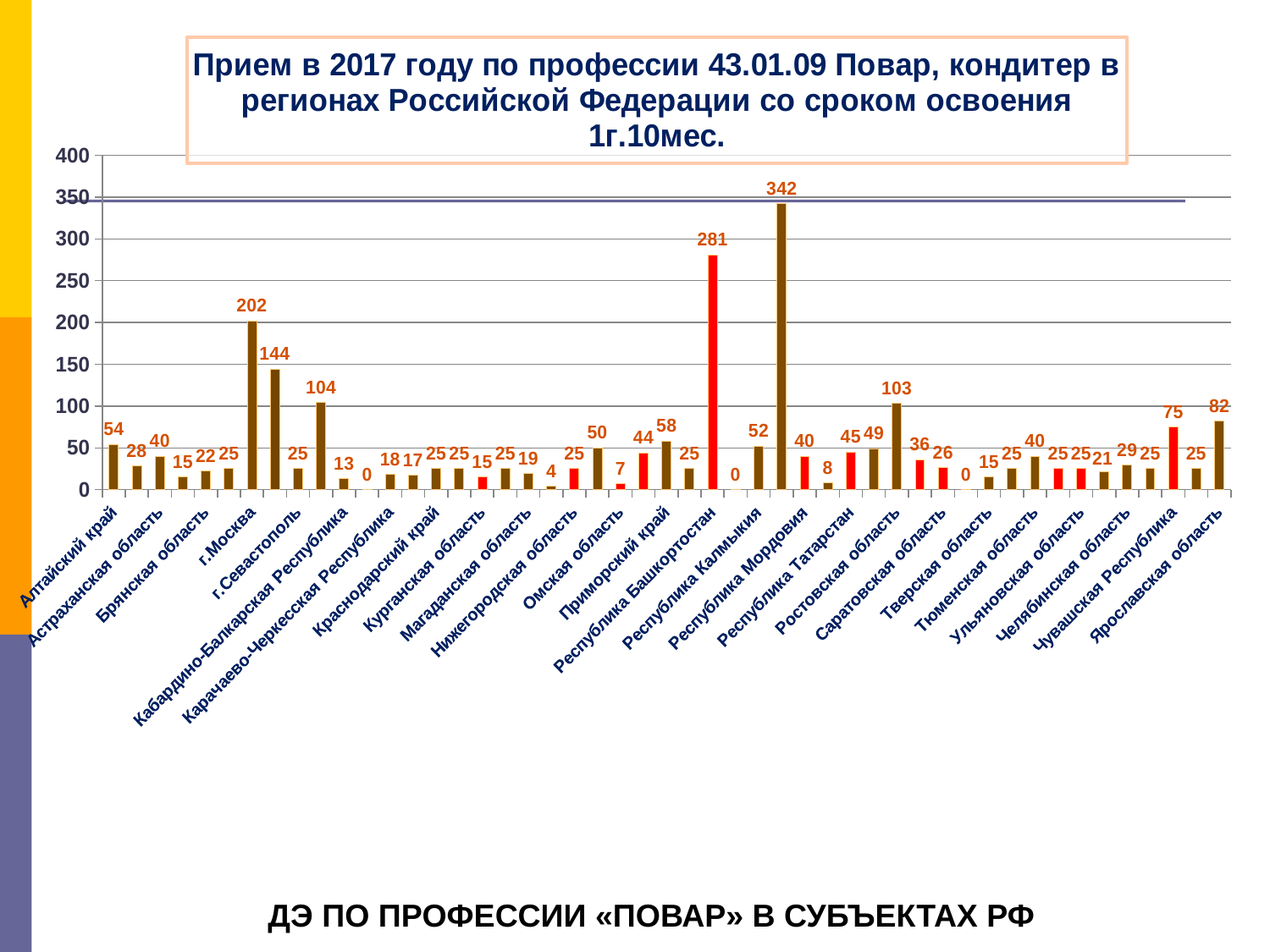
Is the value for Республика Башкортостан greater or less than 250? greater What is the value for Ростовская область? 103 Which has a larger value, г.Москва or Республика Башкортостан? Республика Башкортостан What is the value for Республика Башкортостан? 281 What is the difference between the values for г.Москва and Ростовская область? 99 What is the highest value labelled on the chart? 342 What is the maximum value shown on the vertical axis? 400 What is the value for г.Москва? 202 What type of chart is shown on the slide? bar chart What is the difference between the values for Республика Башкортостан and г.Москва? 79 What is the value for Ярославская область? 82 What is the value for Чувашская Республика? 75